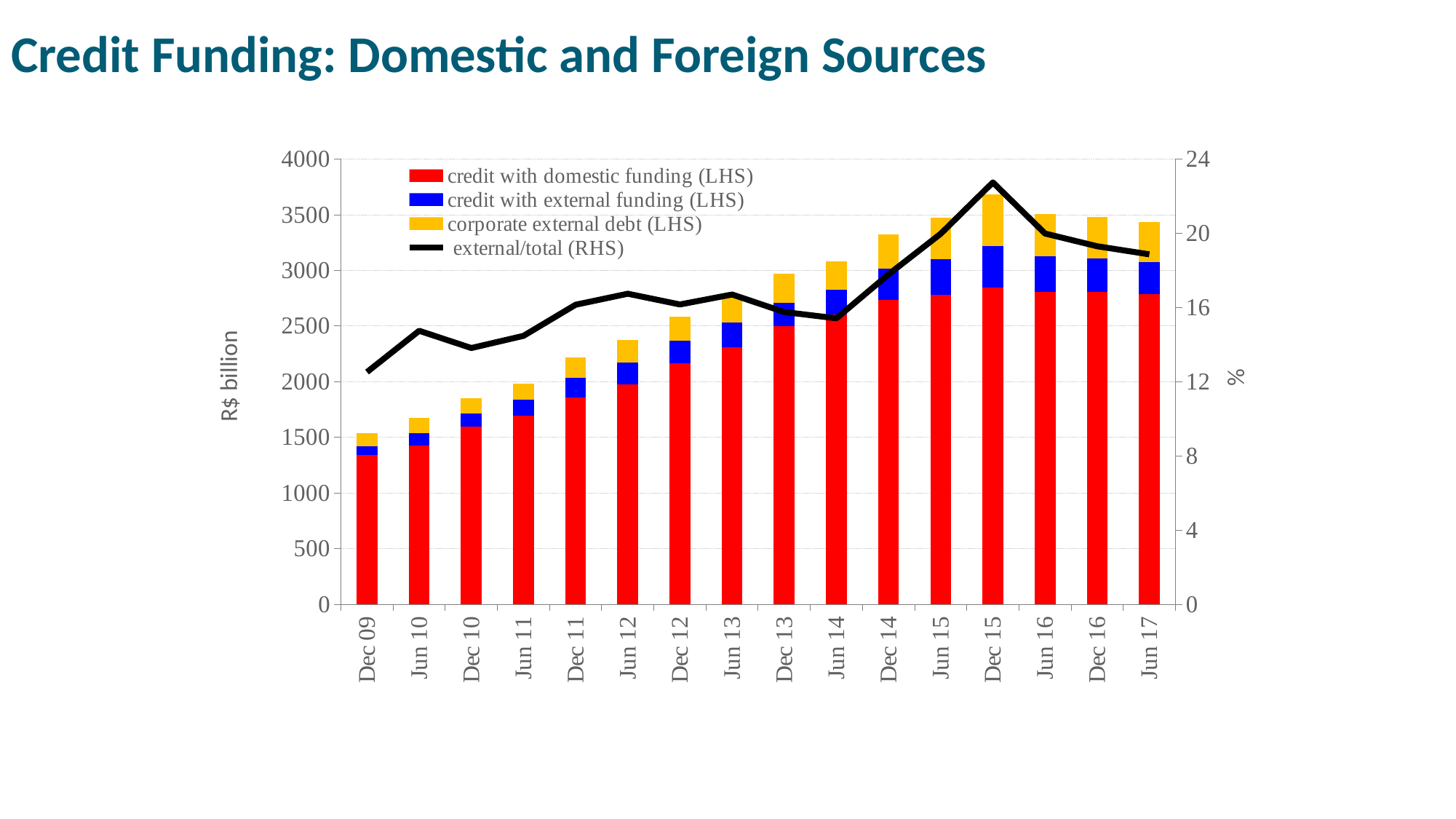
Which period has the tallest stacked bar in total? Dec 15 How many time periods are shown on the x axis? 16 Which period has the shortest stacked bar in total? Dec 09 In which period does the external/total (RHS) line reach its highest value? Dec 15 How many series does the legend list? 4 Is the total stacked bar for Dec 09 greater or less than 2000 R$ billion? less What kind of chart is shown on the slide? A stacked bar chart combined with a line Is the total stacked bar for Jun 17 greater or less than 3000 R$ billion? greater Which is larger, the external/total (RHS) value for Dec 15 or for Jun 17? Dec 15 In which period is the external/total (RHS) line at its lowest value? Dec 09 What is the label on the left vertical axis? R$ billion Is the external/total (RHS) value for Dec 15 greater or less than 20%? greater